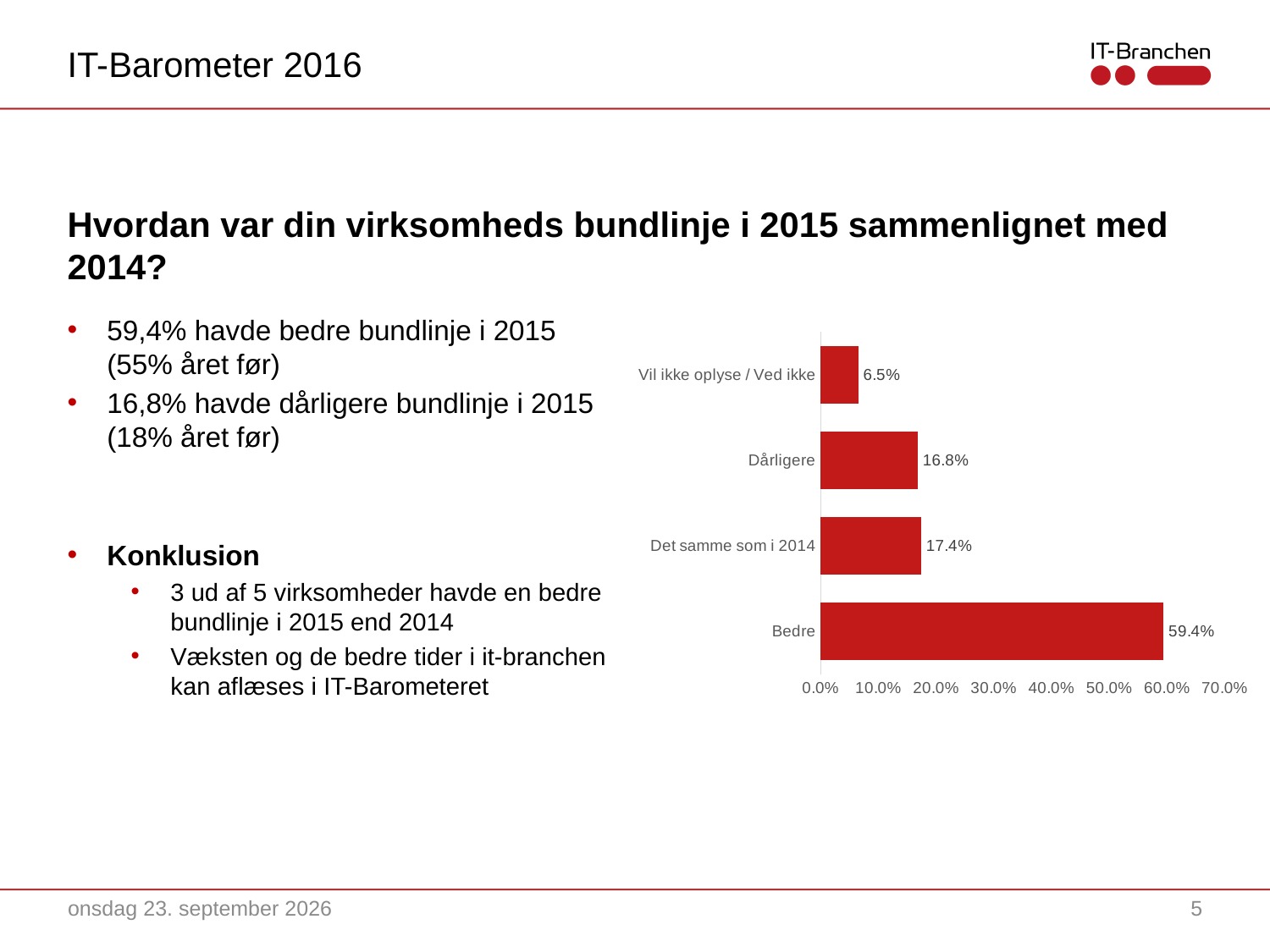
What is the value for Dårligere? 16.8% How many categories are shown in the chart? 4 What is the difference between the values for Bedre and Dårligere? 42.6% What is the difference between the values for Det samme som i 2014 and Vil ikke oplyse / Ved ikke? 10.9% What is the value for Vil ikke oplyse / Ved ikke? 6.5% Is the value for Bedre greater or less than 50.0%? greater What is the value for Det samme som i 2014? 17.4% Which category has the highest value? Bedre Which category has the lowest value? Vil ikke oplyse / Ved ikke What is the value for Bedre? 59.4% Which is larger, the value for Bedre or the value for Det samme som i 2014? Bedre What kind of chart is shown on the slide? bar chart